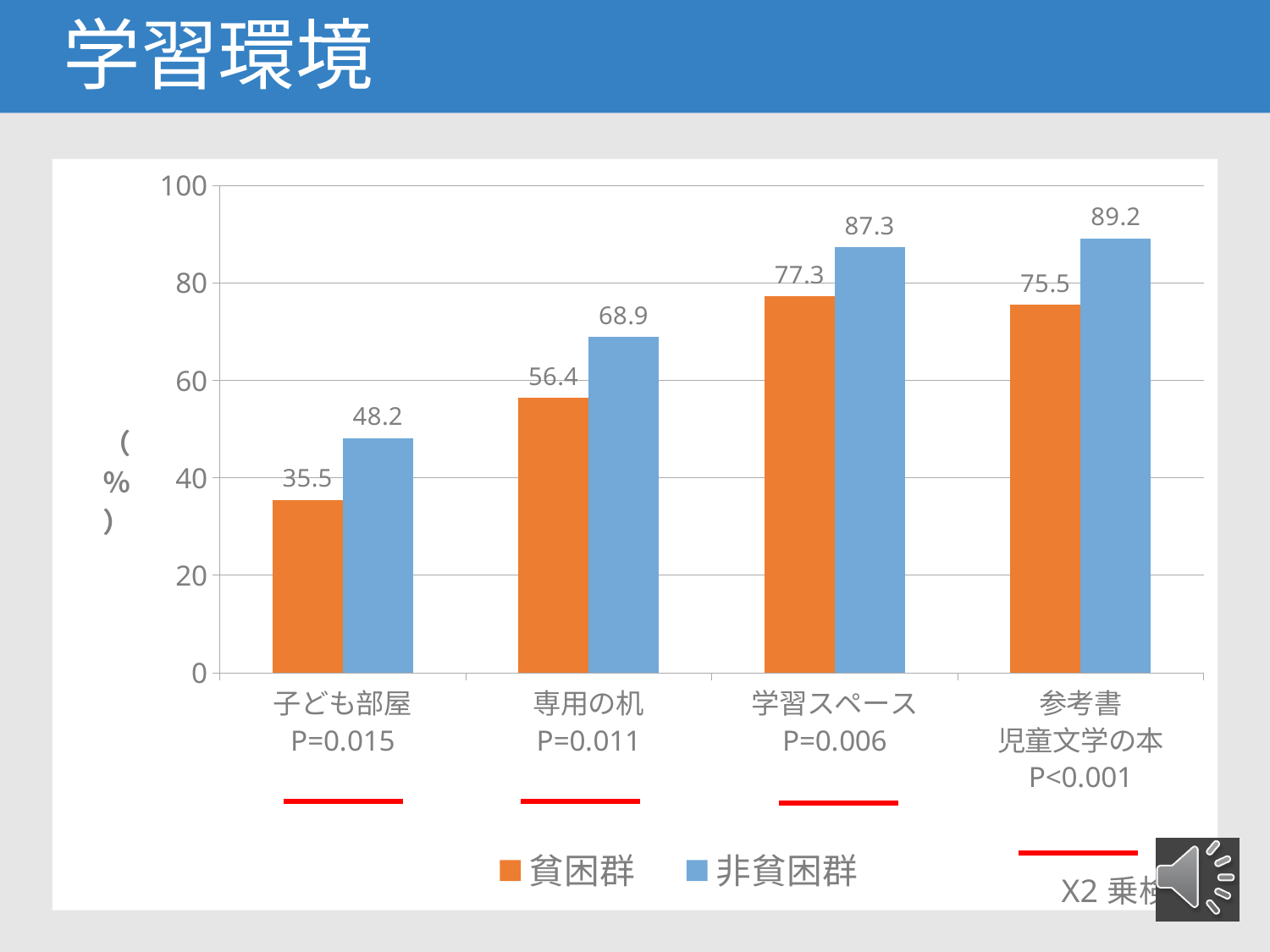
How many series does the legend list? 2 Which category has the highest value for 非貧困群? 参考書・児童文学の本 What is the value for 貧困群 in the 子ども部屋 category? 35.5 What is the value for 非貧困群 in the 参考書・児童文学の本 category? 89.2 How many categories are shown on the x axis? 4 What is the P value shown under the 専用の机 category? P=0.011 What kind of chart is shown on the slide? bar chart What is the difference between 非貧困群 and 貧困群 in the 子ども部屋 category? 12.7 What is the value for 貧困群 in the 学習スペース category? 77.3 What is the value for 非貧困群 in the 専用の机 category? 68.9 Which category has the lowest value for 貧困群? 子ども部屋 Which is larger in the 学習スペース category, 貧困群 or 非貧困群? 非貧困群